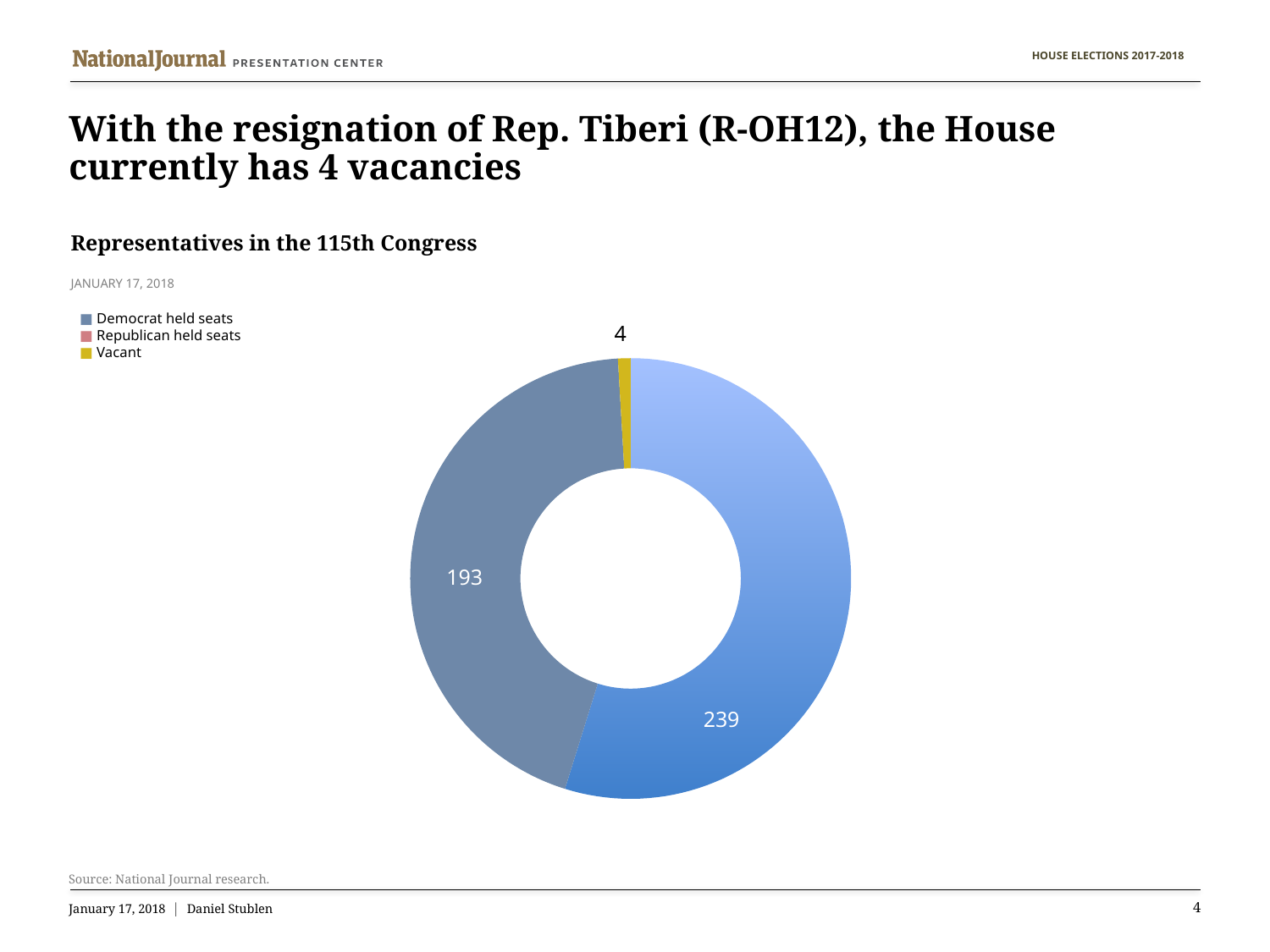
How many entries does the legend list? 3 Which is larger, the 193 slice or the 239 slice? 239 What is the value shown for Democrat held seats? 193 What is the value shown for the Vacant slice? 4 What is the difference between the two largest slices, 239 and 193? 46 What is the value shown for Republican held seats? 239 What is the total of all three slices in the pie chart? 436 What is the title of the chart? Representatives in the 115th Congress What type of chart is shown on the slide? Pie chart (donut) Which category has the smallest slice in the pie chart? Vacant How many slices does the pie chart have? 3 Which category has the largest slice in the pie chart? Republican held seats